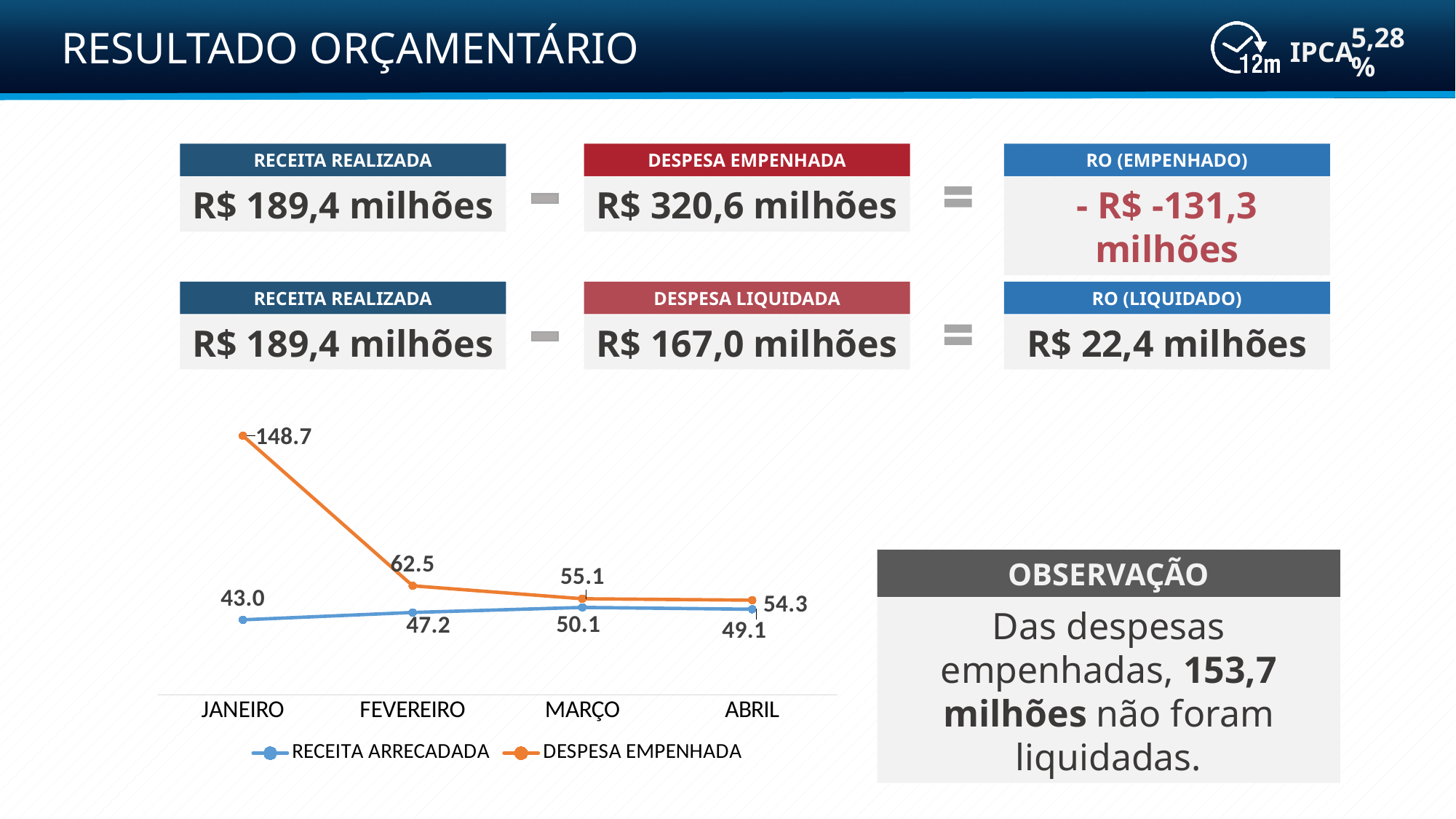
Does DESPESA EMPENHADA rise or fall from JANEIRO to ABRIL? Fall What type of chart is shown on the slide? Line chart How many series does the chart legend list? 2 In which month is DESPESA EMPENHADA highest? JANEIRO What is the value of DESPESA EMPENHADA in JANEIRO? 148.7 Which is larger in FEVEREIRO, RECEITA ARRECADADA or DESPESA EMPENHADA? DESPESA EMPENHADA What is the value of RECEITA ARRECADADA in ABRIL? 49.1 In which month is RECEITA ARRECADADA lowest? JANEIRO What is the value of RECEITA ARRECADADA in MARÇO? 50.1 What is the difference between DESPESA EMPENHADA and RECEITA ARRECADADA in JANEIRO? 105.7 Which colour is used for the DESPESA EMPENHADA line? Orange How many months are plotted on the x axis of the chart? 4